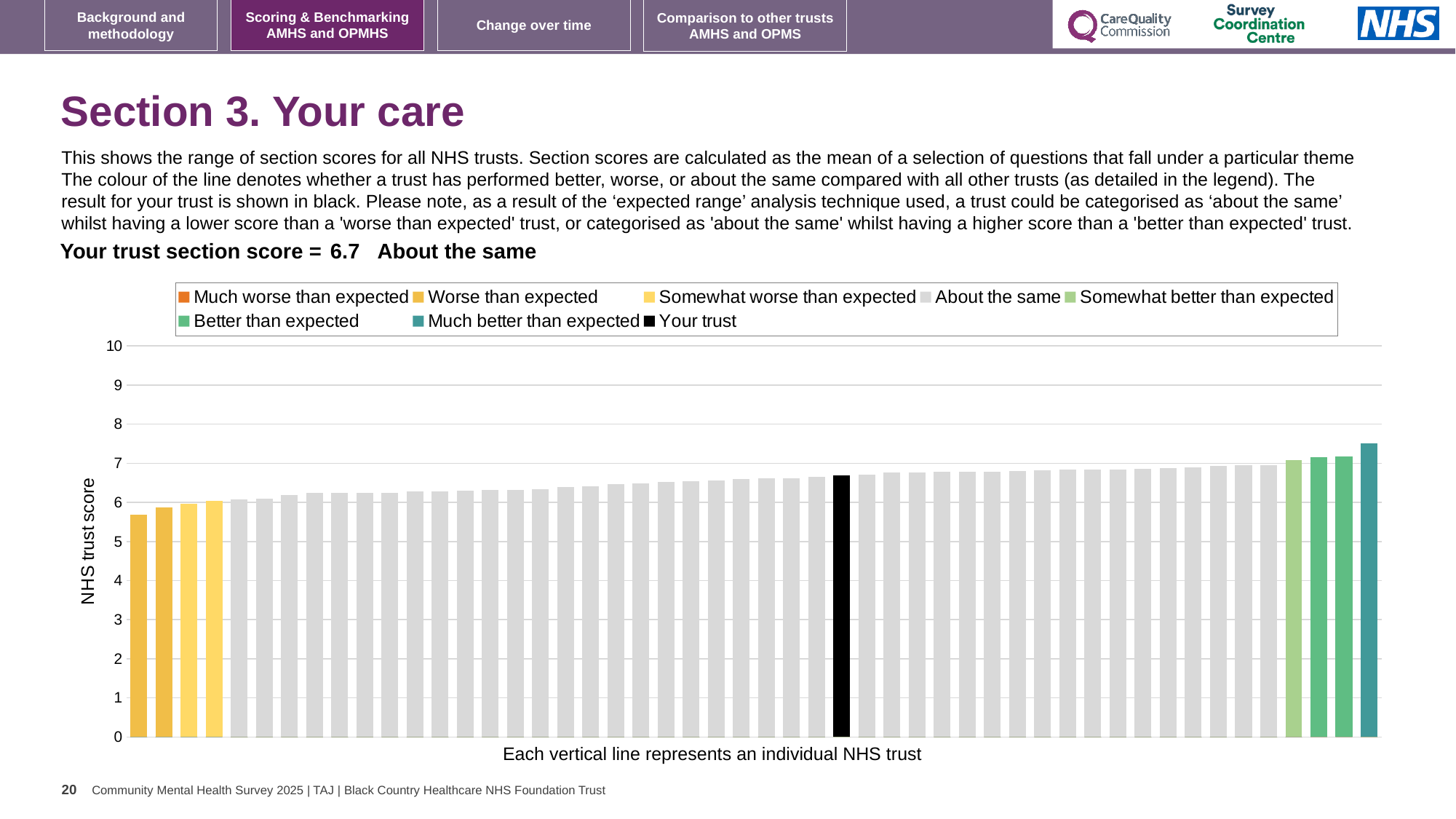
How many bars are coloured as 'Much better than expected'? 1 Is the value of the highest bar in the chart greater or less than 7? greater Do the bar values rise or fall from left to right along the x axis? rise Is the value of the highest bar in the chart greater or less than 8? less Is the value for your trust (the black bar) greater or less than 5? greater What kind of chart is shown on the slide? bar chart Which legend category does the tallest bar in the chart belong to? Much better than expected How many entries does the chart legend list? 8 What does the caption below the x axis say each vertical line represents? an individual NHS trust Which performance category is your trust placed in for Section 3? About the same What is the section score for your trust shown on the slide? 6.7